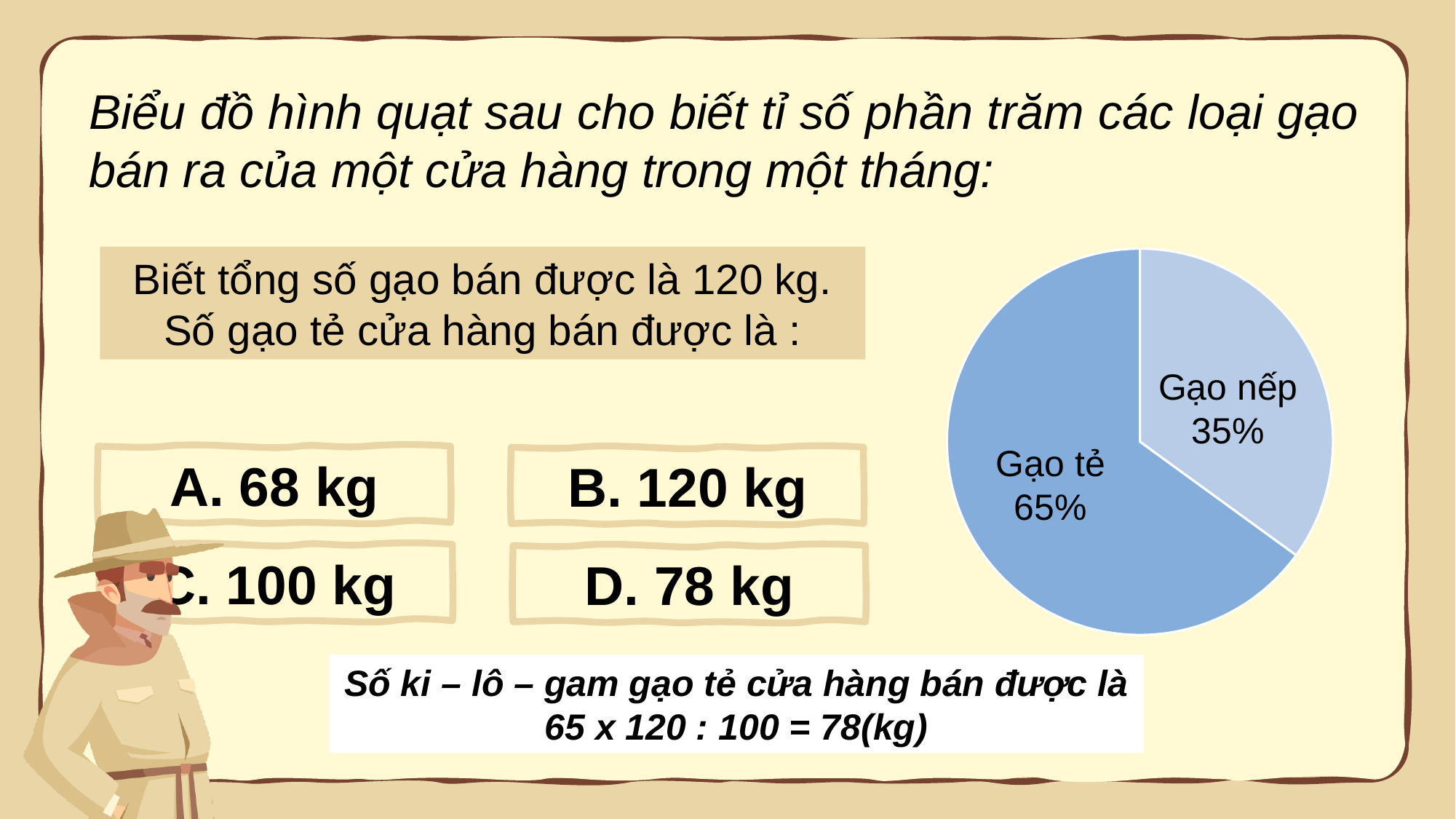
What is the total of the two slices shown in the pie chart? 100% What share of the pie does Gạo nếp represent? 35% Is the share for Gạo tẻ greater or less than 50%? greater Which slice of the pie is shown in the lighter blue colour? Gạo nếp What share of the pie does Gạo tẻ represent? 65% Which is larger, the slice for Gạo tẻ or the slice for Gạo nếp? Gạo tẻ Is the share for Gạo nếp greater or less than 50%? less How many categories are shown in the pie chart? 2 What is the difference in percentage points between Gạo tẻ and Gạo nếp? 30% Which category has the smallest slice of the pie? Gạo nếp What kind of chart is shown on the slide? Pie chart Which category has the largest slice of the pie? Gạo tẻ